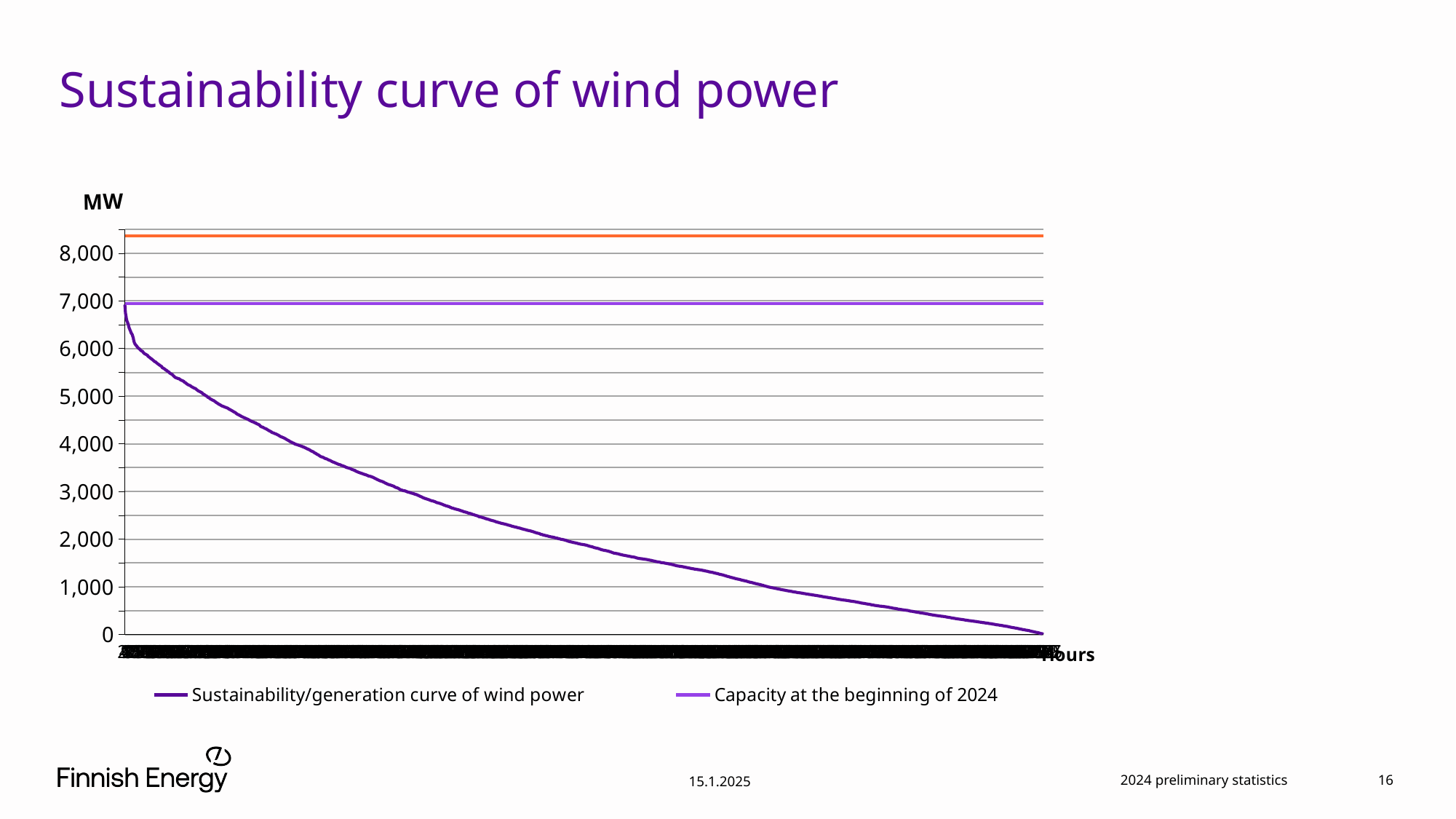
Is the lowest point of the sustainability/generation curve of wind power greater or less than 1,000 MW? less Is the highest point of the sustainability/generation curve of wind power greater or less than 6,000 MW? greater Does the sustainability/generation curve of wind power rise or fall along the x axis? Fall Is the value of the orange horizontal line greater or less than 8,000 MW? greater Which is higher on the chart: the orange horizontal line or the 'Capacity at the beginning of 2024' line? The orange horizontal line What unit is shown on the vertical axis of the chart? MW How many series does the chart legend list? 2 What is the label of the horizontal axis of the chart? Hours What kind of chart is shown on the slide? Line chart